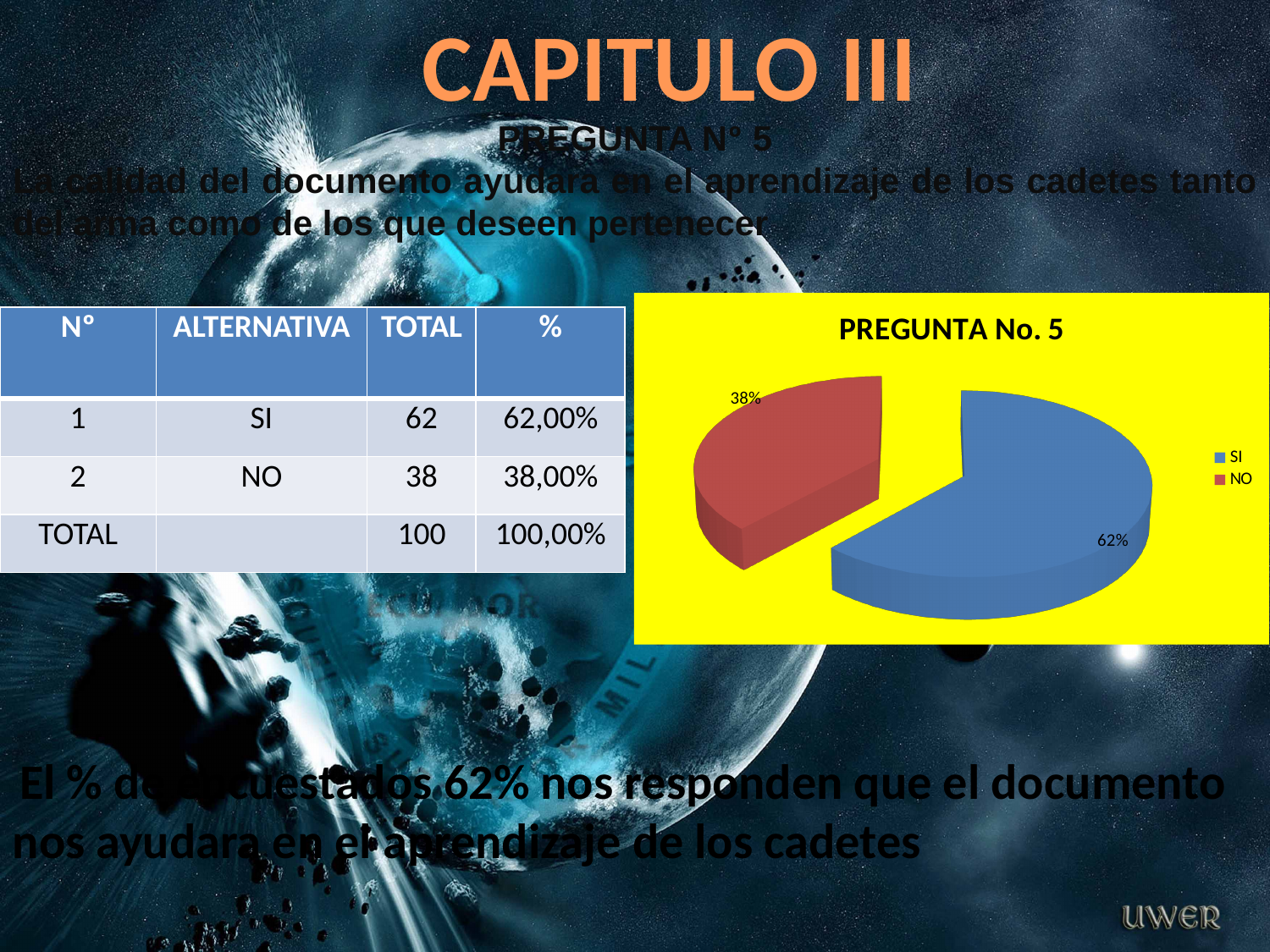
What type of chart is shown on the slide? pie chart Which category has the smallest slice in the pie chart? NO Which category has the largest slice in the pie chart? SI How many slices does the pie chart have? 2 Is the SI slice's share greater or less than 50%? greater What percentage does the SI slice show in the pie chart? 62% How many entries does the chart legend list? 2 What percentage does the NO slice show in the pie chart? 38% What colour is the SI slice in the pie chart? blue What is the title of the chart? PREGUNTA No. 5 What is the difference in percentage points between the SI and NO slices? 24 Which slice is larger, SI or NO? SI